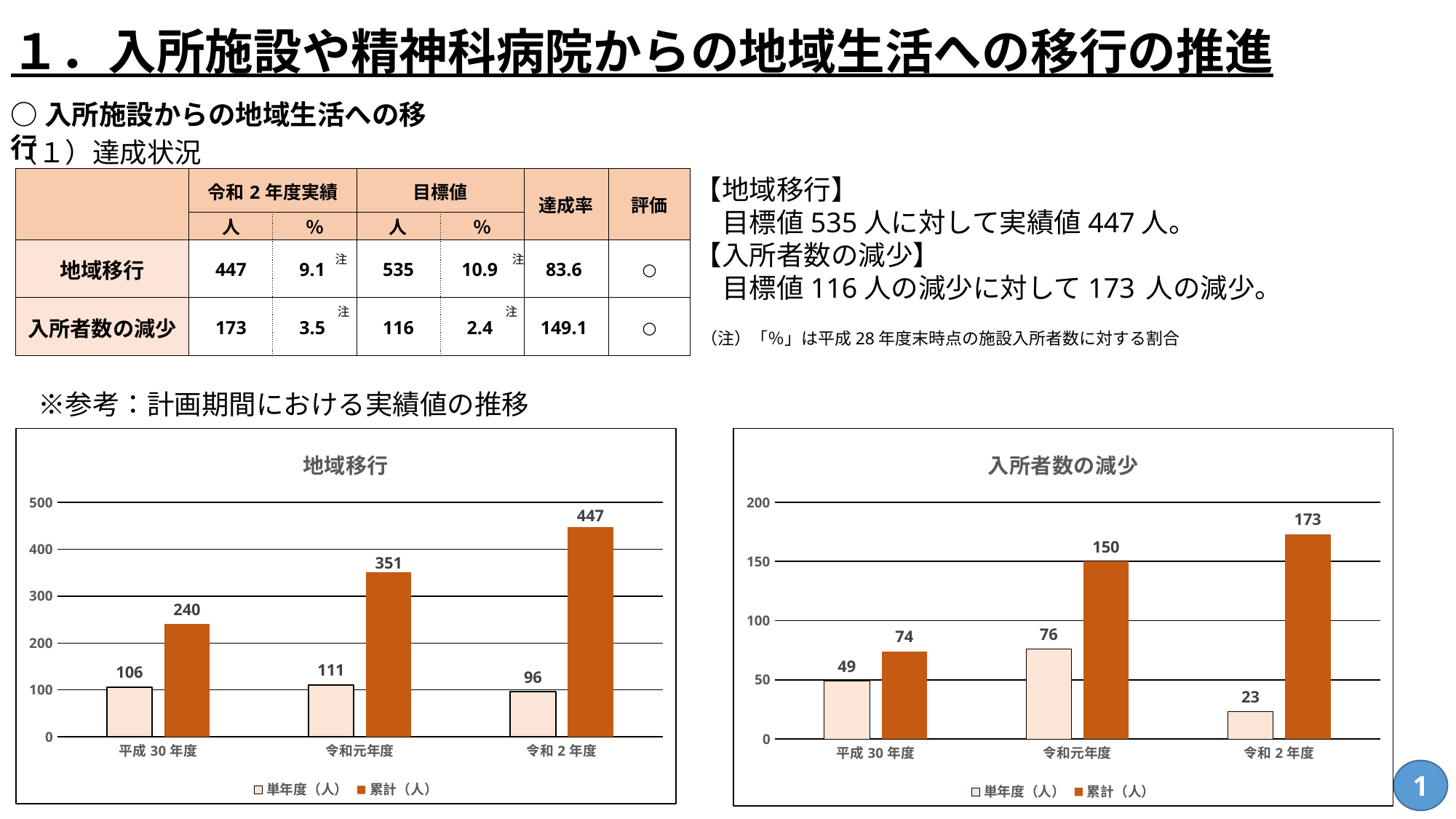
In the 入所者数の減少 chart, which is larger: the 単年度（人） value for 平成30年度 or for 令和元年度? 令和元年度 In the 地域移行 chart, which year has the lowest 単年度（人） value? 令和２年度 In the 地域移行 chart, what is the 累計（人） value for 令和２年度? 447 How many series does the legend of the 入所者数の減少 chart list? 2 In the 地域移行 chart, what is the 単年度（人） value for 令和元年度? 111 What kind of chart is the 地域移行 chart? Bar chart In the 入所者数の減少 chart, what is the 単年度（人） value for 令和２年度? 23 In the 入所者数の減少 chart, which year has the highest 単年度（人） value? 令和元年度 In the 地域移行 chart, what is the difference between the 累計（人） values for 令和２年度 and 令和元年度? 96 In the 入所者数の減少 chart, what is the 累計（人） value for 平成30年度? 74 In the 入所者数の減少 chart, what is the difference between the 累計（人） values for 令和元年度 and 平成30年度? 76 In the 地域移行 chart, how does the 累計（人） series change from 平成30年度 to 令和２年度? It rises